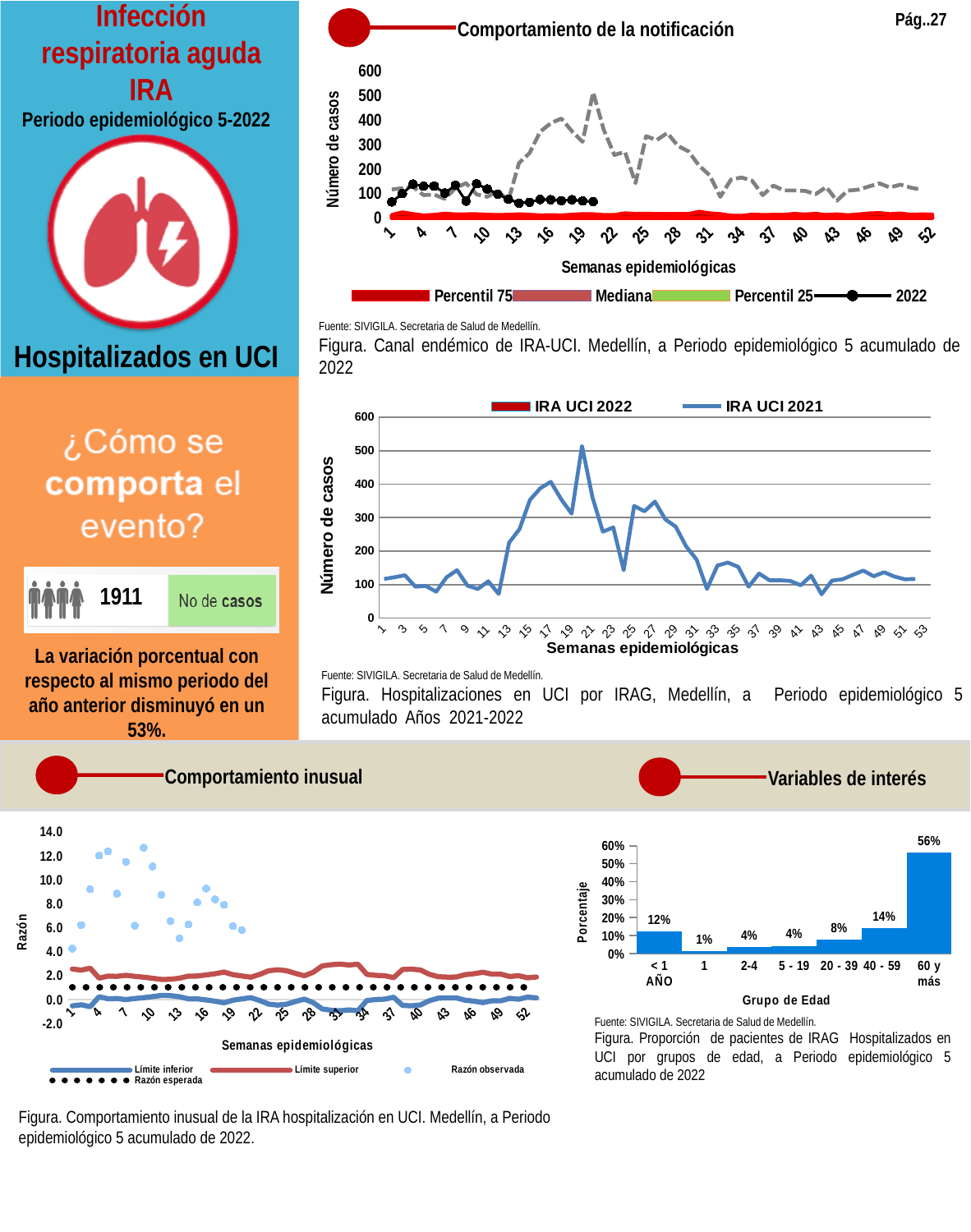
How many series does the legend of the 'Canal endémico de IRA-UCI' chart (top right) list? 4 In the bar chart by age group (bottom right), which age group has the lowest percentage? 1 How many series does the legend of the 'Hospitalizaciones en UCI por IRAG' chart (middle right) list? 2 How many age groups are shown in the bar chart at the bottom right? 7 In the 'Hospitalizaciones en UCI por IRAG' chart (middle right), is the peak value of IRA UCI 2021 around week 20 greater or less than 400? greater In the bar chart by age group (bottom right), which age group has the highest percentage? 60 y más In the bar chart of IRAG patients hospitalized in UCI by age group (bottom right), what is the percentage for the '60 y más' group? 56% In the bar chart by age group (bottom right), which is larger: the '< 1 AÑO' group or the '20 - 39' group? < 1 AÑO In the bar chart by age group (bottom right), what is the percentage for the '< 1 AÑO' group? 12% What kind of chart is the 'Grupo de Edad' chart at the bottom right? Bar chart In the bar chart by age group (bottom right), what is the difference between the '60 y más' group and the '40 - 59' group? 42% What kind of chart is the 'Comportamiento inusual' chart at the bottom left, showing Razón by Semanas epidemiológicas? Line chart